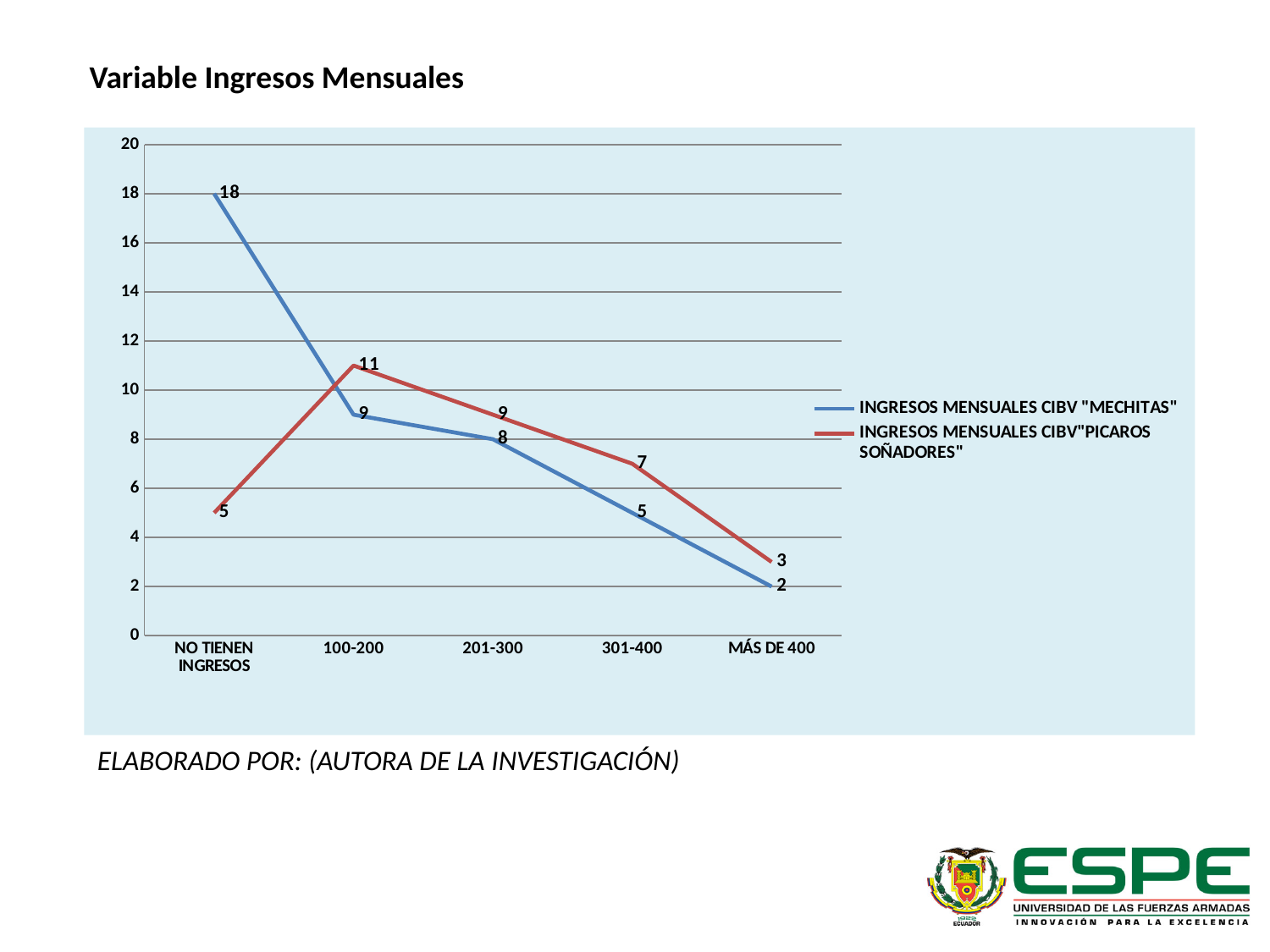
What kind of chart is shown on the slide? line chart What is the value for "NO TIENEN INGRESOS" in the INGRESOS MENSUALES CIBV "MECHITAS" series? 18 Does the INGRESOS MENSUALES CIBV "MECHITAS" series rise or fall from "NO TIENEN INGRESOS" to "MÁS DE 400"? fall How many categories are shown on the x axis? 5 Which category has the highest value in the INGRESOS MENSUALES CIBV"PICAROS SOÑADORES" series? 100-200 Which category has the lowest value in the INGRESOS MENSUALES CIBV "MECHITAS" series? MÁS DE 400 What is the value for "MÁS DE 400" in the INGRESOS MENSUALES CIBV "MECHITAS" series? 2 How many series does the legend list? 2 At "301-400", which series has the larger value? INGRESOS MENSUALES CIBV"PICAROS SOÑADORES" What is the value for "100-200" in the INGRESOS MENSUALES CIBV"PICAROS SOÑADORES" series? 11 What is the difference between the two series at "NO TIENEN INGRESOS"? 13 Is the value for "201-300" in the INGRESOS MENSUALES CIBV "MECHITAS" series greater or less than 10? less